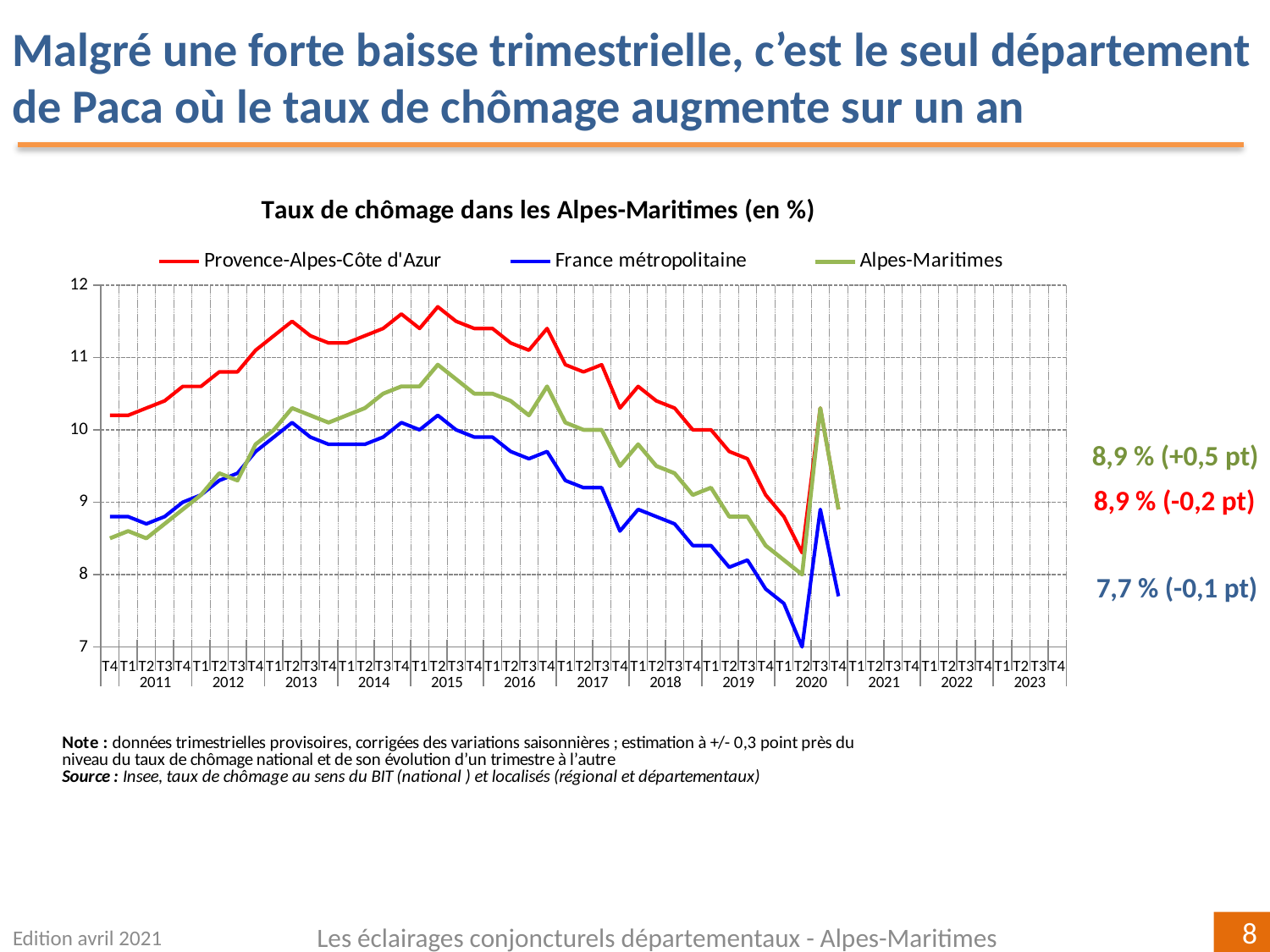
Which series has the lowest value at the end of the plotted period? France métropolitaine Is the value for Provence-Alpes-Côte d'Azur in T1 2015 greater or less than 11? greater What is the title of the chart? Taux de chômage dans les Alpes-Maritimes (en %) What one-year change is annotated for Alpes-Maritimes? +0,5 pt What is the latest unemployment rate shown for France métropolitaine? 7,7 % What is the latest unemployment rate shown for Alpes-Maritimes? 8,9 % Is the value for France métropolitaine in T2 2020 greater or less than 8? less Does the Provence-Alpes-Côte d'Azur line rise or fall between 2016 and 2019? fall What kind of chart is shown on the slide? line chart What is the latest unemployment rate shown for Provence-Alpes-Côte d'Azur? 8,9 % What is the difference between the latest values for Alpes-Maritimes and France métropolitaine? 1,2 How many series does the legend list? 3